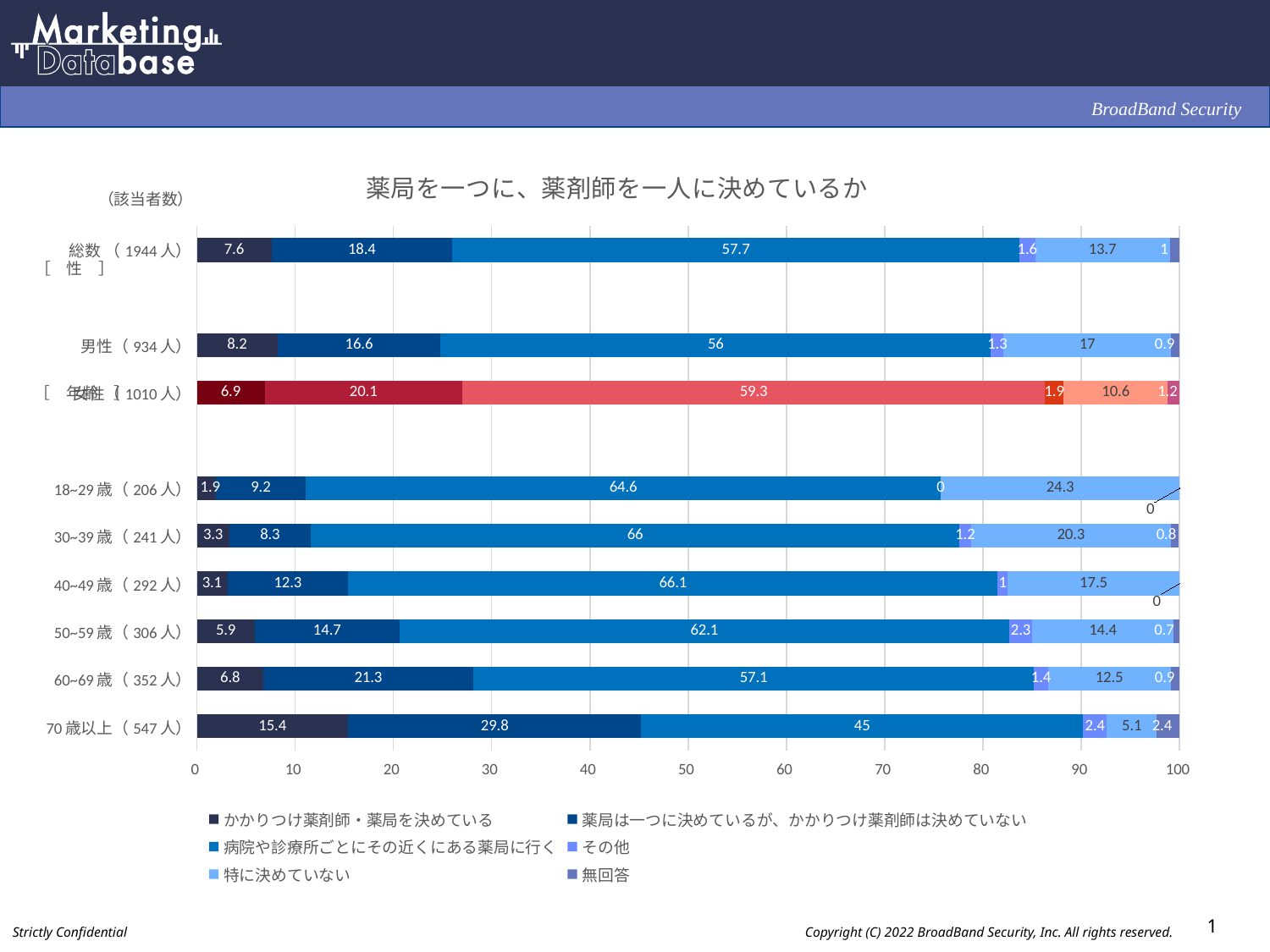
What is the value of かかりつけ薬剤師・薬局を決めている for 70歳以上 (547人)? 15.4 What kind of chart is shown on the slide? Stacked bar chart How many category bars are plotted in the chart? 9 What is the title of the chart? 薬局を一つに、薬剤師を一人に決めているか Which has the larger value for 特に決めていない, 男性 (934人) or 女性 (1010人)? 男性 (934人) What is the total of the stacked bar for 総数 (1944人)? 100 How many series does the legend list? 6 What is the value of 特に決めていない for 18~29歳 (206人)? 24.3 What is the value of 病院や診療所ごとにその近くにある薬局に行く for 総数 (1944人)? 57.7 Which category has the highest value for かかりつけ薬剤師・薬局を決めている? 70歳以上 (547人) What is the difference between the 薬局は一つに決めているが、かかりつけ薬剤師は決めていない values for 70歳以上 (547人) and 60~69歳 (352人)? 8.5 Which category has the lowest value for 病院や診療所ごとにその近くにある薬局に行く? 70歳以上 (547人)